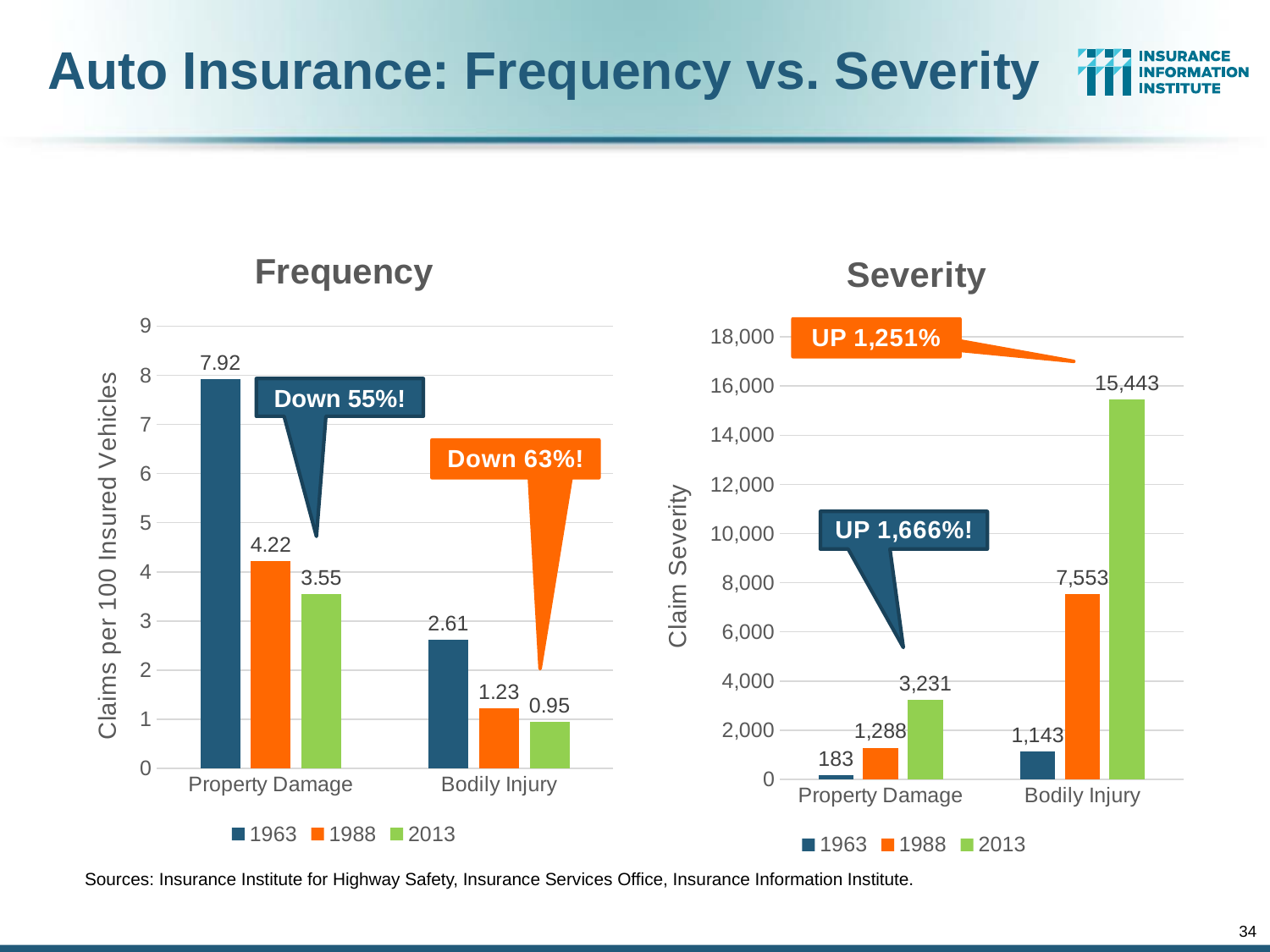
In the Frequency chart, what is the value for Property Damage in 1963? 7.92 In the Severity chart, which is larger: Property Damage in 2013 or Bodily Injury in 1988? Bodily Injury in 1988 In the Severity chart, what is the difference between the 2013 and 1988 values for Bodily Injury? 7,890 What kind of chart is the Severity chart? Bar chart In the Severity chart, which year has the lowest value for Bodily Injury? 1963 In the Severity chart, what is the value for Bodily Injury in 2013? 15,443 In the Frequency chart, what is the difference between the 1988 and 2013 values for Property Damage? 0.67 What is the y-axis label of the Frequency chart? Claims per 100 Insured Vehicles In the Severity chart, what is the value for Property Damage in 1963? 183 In the Frequency chart, which year has the highest value for Property Damage? 1963 In the Frequency chart, what is the value for Bodily Injury in 2013? 0.95 In the Frequency chart, how many series does the legend list? 3